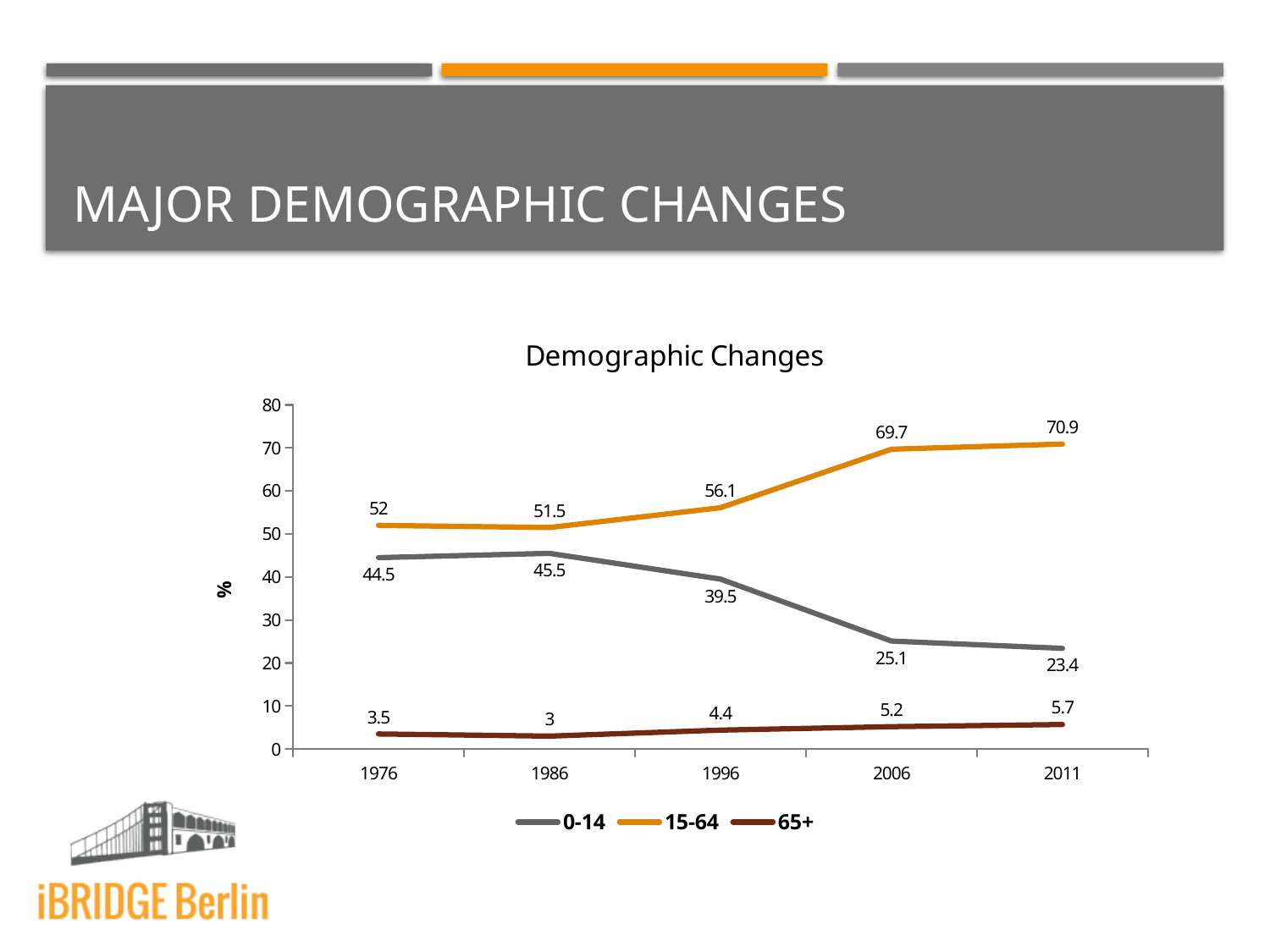
What is the difference between the 15-64 value in 2011 and the 15-64 value in 1976? 18.9 How many series does the legend list? 3 What is the value for the 65+ series in 1986? 3 In which year is the 0-14 series at its highest? 1986 What is the difference between the 0-14 value in 1976 and the 0-14 value in 2011? 21.1 What kind of chart is shown? line chart In which year is the 15-64 series at its lowest? 1986 Which is larger in 2006: the 0-14 value or the 15-64 value? 15-64 What is the value for the 15-64 series in 2011? 70.9 What is the value for the 0-14 series in 1996? 39.5 Does the 0-14 series rise or fall from 1986 to 2011? fall How many years are plotted on the x axis? 5